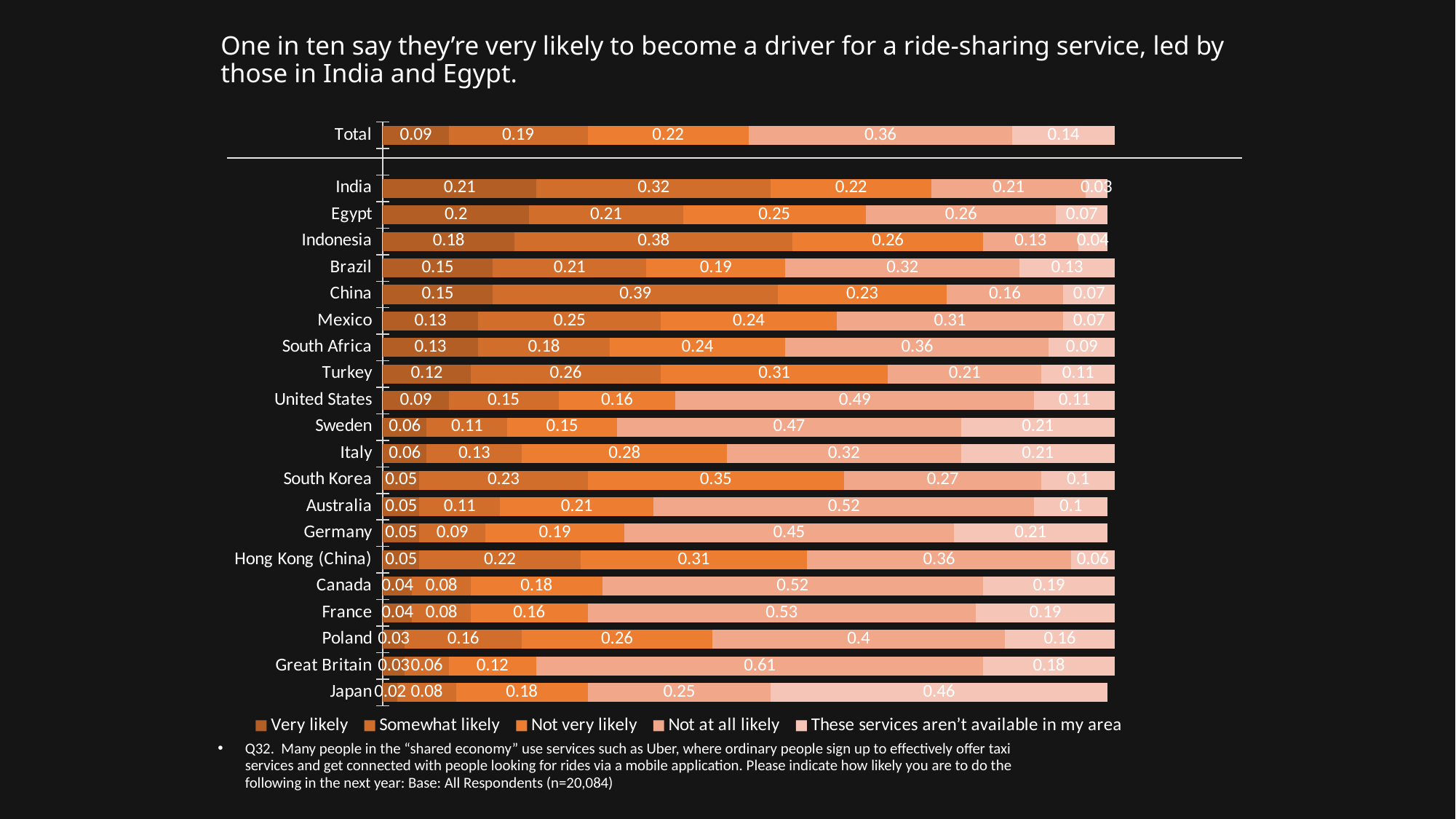
Which country has the lowest 'Very likely' value? Japan What is the 'Not very likely' value for the Total bar? 0.22 What is the value for Japan in the 'These services aren't available in my area' series? 0.46 What kind of chart is shown on the slide? Stacked bar chart Which country has the highest 'Not at all likely' value? Great Britain What is the 'Not at all likely' value for Great Britain? 0.61 Which has a larger 'Not at all likely' value, Australia or Sweden? Australia What is the difference between India's 'Very likely' value and the Total 'Very likely' value? 0.12 How many series does the legend list? 5 How many countries (excluding Total) are shown in the chart? 20 What is the 'Very likely' value for India? 0.21 What is the difference between the 'Not at all likely' values for Great Britain and France? 0.08